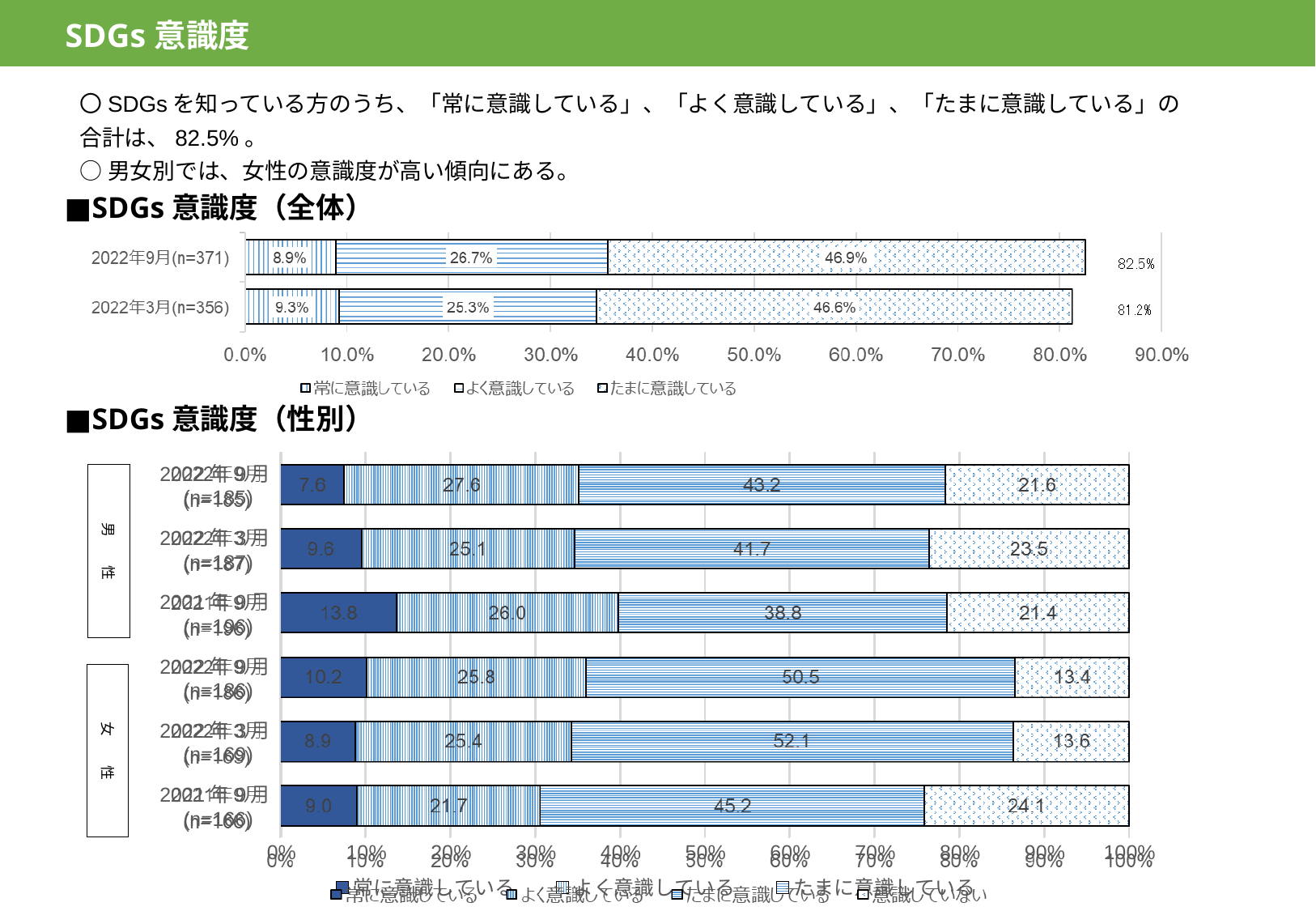
In the top chart (SDGs 意識度（全体）), what are the three legend entries? 常に意識している, よく意識している, たまに意識している In the bottom chart (SDGs 意識度（性別）), what is the value for たまに意識している for 女性 in 2022年3月? 52.1 In the top chart (SDGs 意識度（全体）), what is the difference in よく意識している between 2022年9月(n=371) and 2022年3月(n=356)? 1.4 percentage points In the top chart (SDGs 意識度（全体）), what is the total shown at the end of the 2022年9月(n=371) bar? 82.5% In the top chart (SDGs 意識度（全体）), how many bars (periods) are plotted? 2 In the top chart (SDGs 意識度（全体）), which period has the larger value for 常に意識している, 2022年9月(n=371) or 2022年3月(n=356)? 2022年3月(n=356) In the top chart (SDGs 意識度（全体）), how many series does the legend list? 3 What kind of chart is the top chart (SDGs 意識度（全体）)? Stacked horizontal bar chart In the top chart (SDGs 意識度（全体）), what is the total shown at the end of the 2022年3月(n=356) bar? 81.2% In the top chart (SDGs 意識度（全体）), what is the value for 常に意識している in 2022年9月(n=371)? 8.9% In the top chart (SDGs 意識度（全体）), what is the value for たまに意識している in 2022年3月(n=356)? 46.6% In the bottom chart (SDGs 意識度（性別）), what is the value for たまに意識している for 男性 in 2022年9月? 43.2